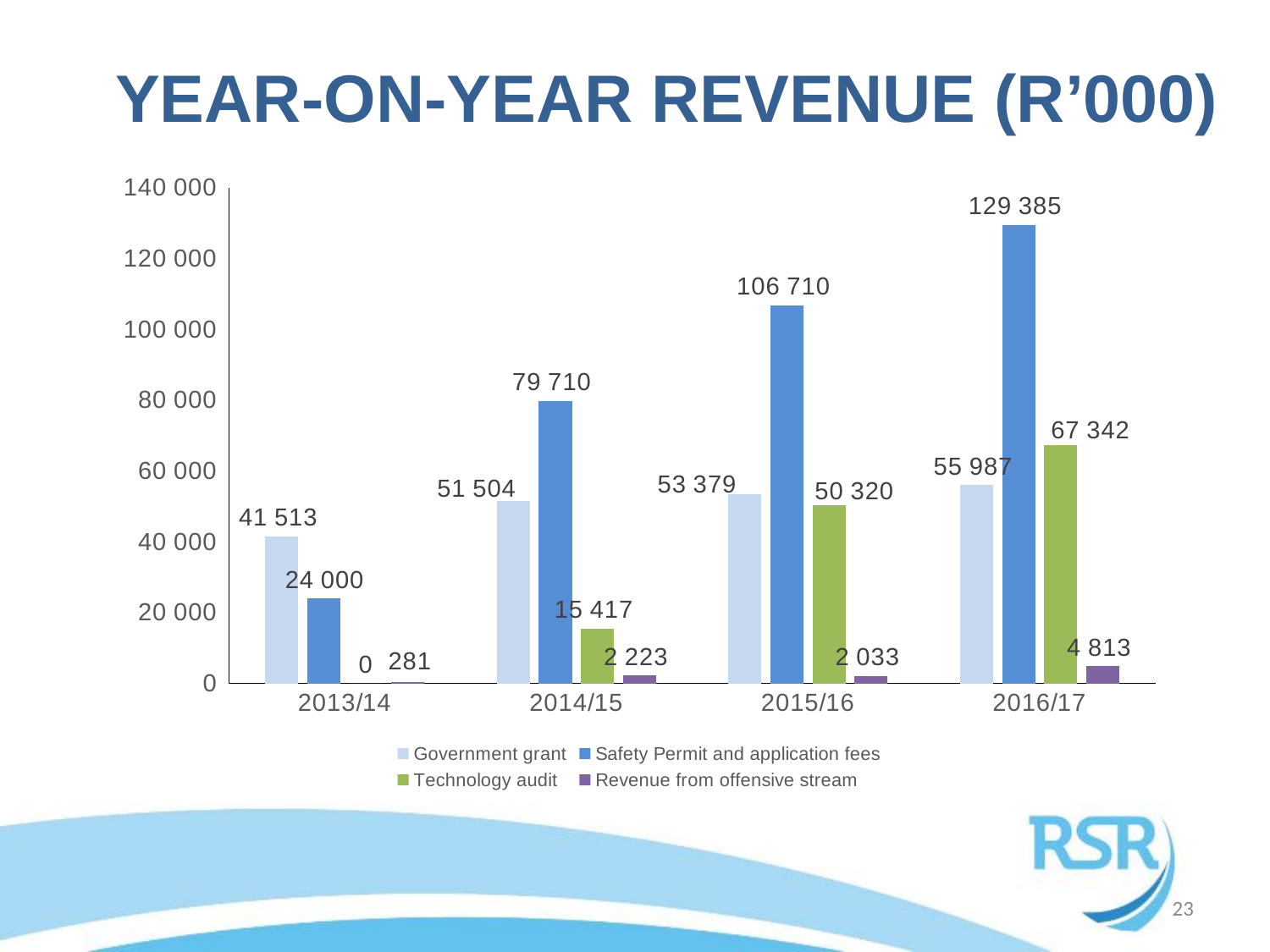
What is the value for Technology audit in 2014/15? 15 417 What is the value for Government grant in 2015/16? 53 379 Which is larger in 2014/15: Government grant or Safety Permit and application fees? Safety Permit and application fees How many years are shown on the x axis? 4 Does Safety Permit and application fees revenue rise or fall from 2013/14 to 2016/17? Rise How many series does the legend list? 4 What type of chart is shown on the slide? Bar chart What is the value for Revenue from offensive stream in 2013/14? 281 What is the difference between Safety Permit and application fees in 2016/17 and 2015/16? 22 675 In which year is Technology audit revenue lowest? 2013/14 In which year is Safety Permit and application fees revenue highest? 2016/17 What is the value for Safety Permit and application fees in 2016/17? 129 385